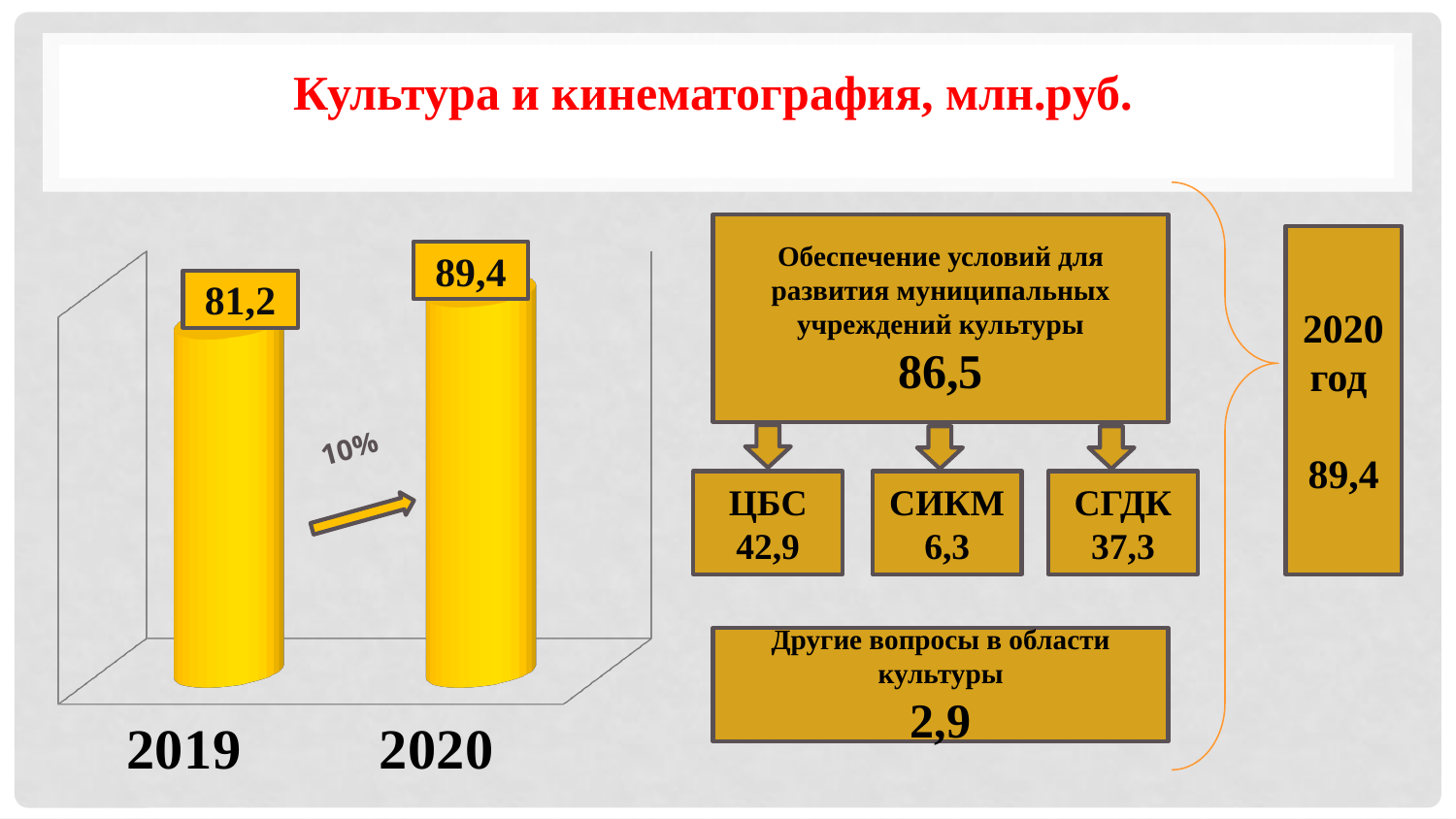
By how much does the 2020 value exceed the 2019 value in the bar chart? 8,2 What is the title of the slide containing the bar chart? Культура и кинематография, млн.руб. What is the value for 2020 in the bar chart? 89,4 Is the value for 2020 larger or smaller than the value for 2019? larger What is the value for 2019 in the bar chart? 81,2 What percentage change is written on the arrow between the two bars? 10% What kind of chart is shown on the left of the slide? bar chart How many bars are shown in the bar chart? 2 Which year has the higher value in the bar chart? 2020 Which year has the lower value in the bar chart? 2019 Do the values rise or fall from 2019 to 2020 in the bar chart? rise